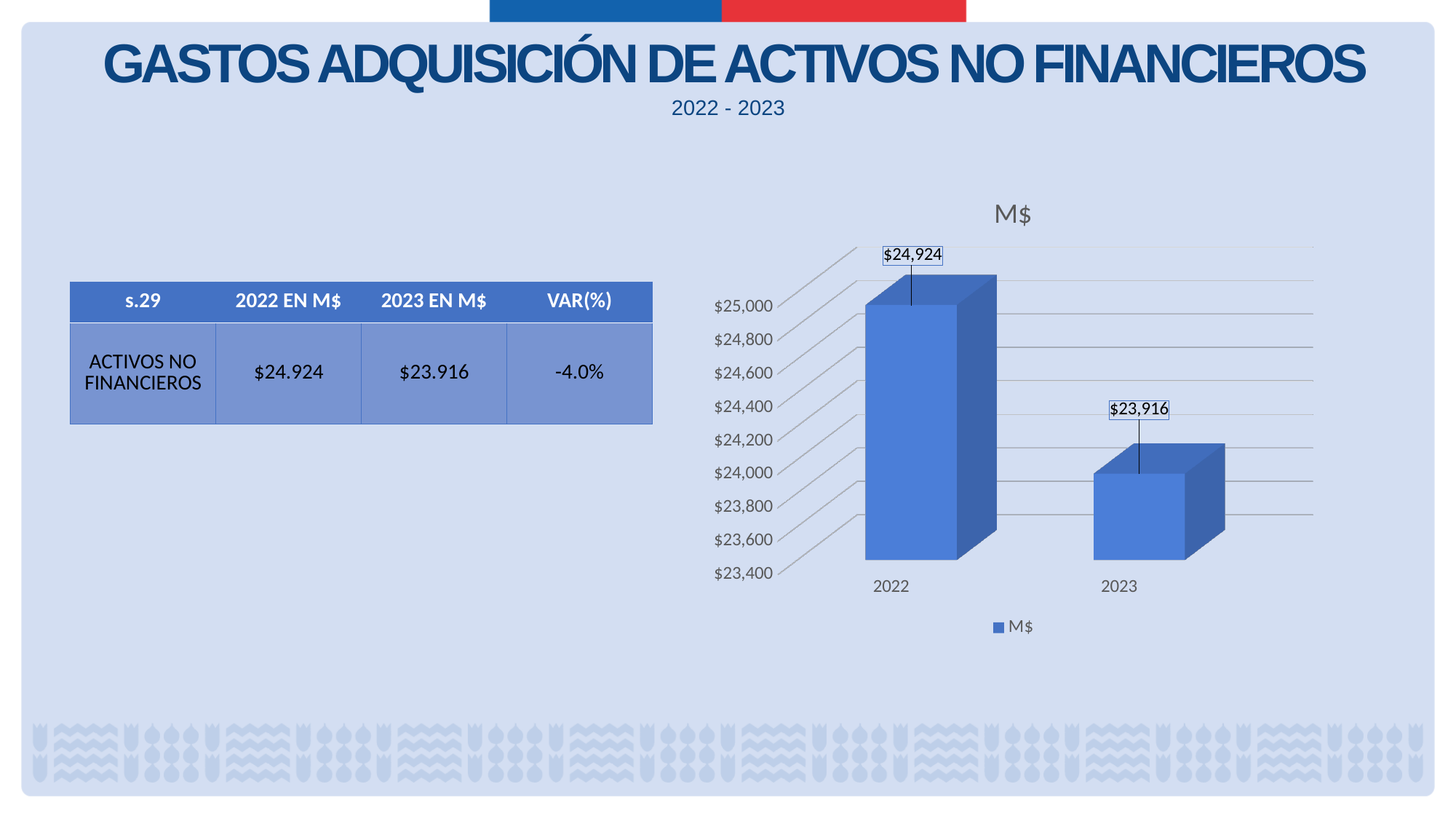
Do the values rise or fall from 2022 to 2023? fall Is the value for 2022 larger or smaller than the value for 2023? larger Which year has the higher value in the chart? 2022 What is the value for 2023 in the chart? $23,916 Is the value for 2022 greater or less than $24,800? greater How many bars are plotted in the chart? 2 What is the value for 2022 in the chart? $24,924 Which year has the lower value in the chart? 2023 What is the difference between the 2022 and 2023 values in the chart? $1,008 Is the value for 2023 greater or less than $24,000? less How many series does the chart legend list? 1 What kind of chart is shown on the slide? bar chart